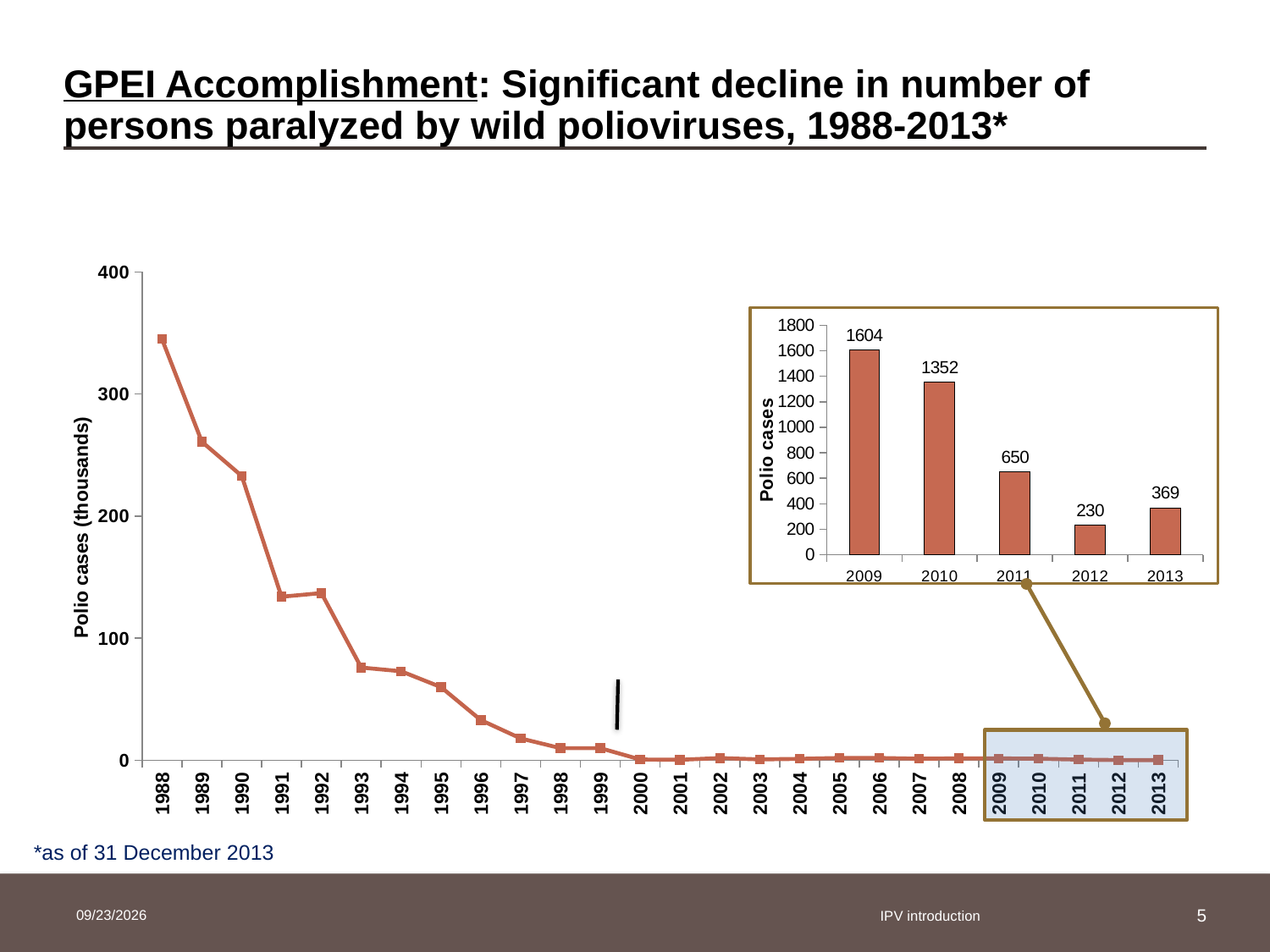
In the inset bar chart, what is the value for 2009? 1604 What kind of chart is the inset chart in the upper right? bar chart In the inset bar chart, which year has the highest number of polio cases? 2009 In the large line chart, do the values generally rise or fall from 1988 to 2013? fall In the inset bar chart, what is the value for 2013? 369 In the inset bar chart, what is the value for 2012? 230 How many years are shown in the inset bar chart? 5 In the large line chart, is the value for 1993 greater or less than 100? less In the large line chart, is the value for 1988 greater or less than 300? greater In the inset bar chart, which is larger, the value for 2012 or the value for 2013? 2013 In the inset bar chart, which year has the lowest number of polio cases? 2012 In the inset bar chart, what is the difference between the values for 2010 and 2011? 702